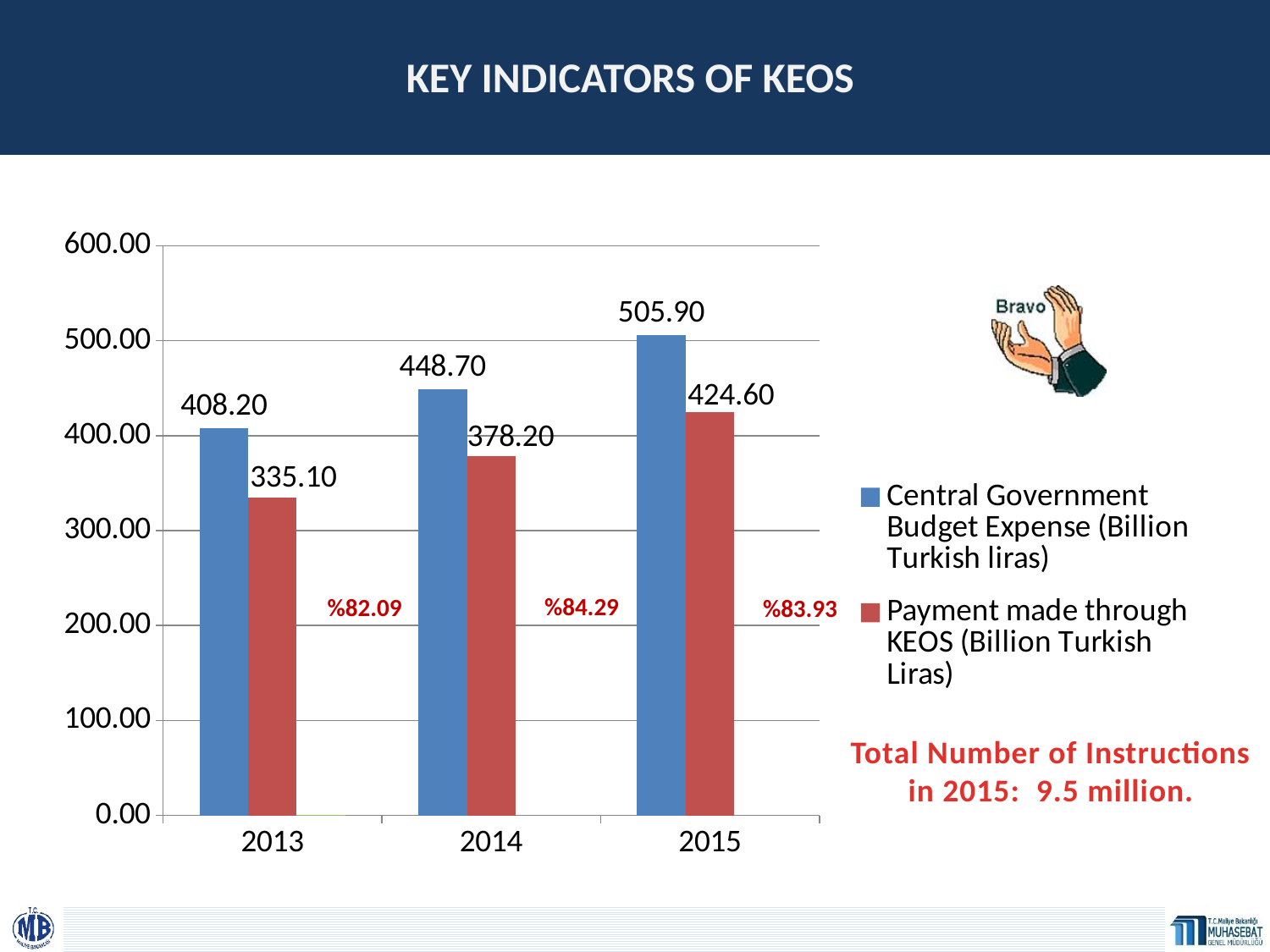
Which is larger in 2014: the Central Government Budget Expense or the Payment made through KEOS? Central Government Budget Expense Is the Payment made through KEOS in 2014 greater or less than 400.00? less What is the Payment made through KEOS (Billion Turkish Liras) for 2015? 424.60 How many years are shown on the x axis of the chart? 3 How many series does the legend list? 2 In which year is the Payment made through KEOS lowest? 2013 What is the difference between the Central Government Budget Expense and the Payment made through KEOS in 2015? 81.30 In which year is the Central Government Budget Expense highest? 2015 What kind of chart is shown on the slide? bar chart What is the Payment made through KEOS (Billion Turkish Liras) for 2013? 335.10 Does the Payment made through KEOS rise or fall from 2013 to 2015? rise What is the Central Government Budget Expense (Billion Turkish liras) for 2014? 448.70